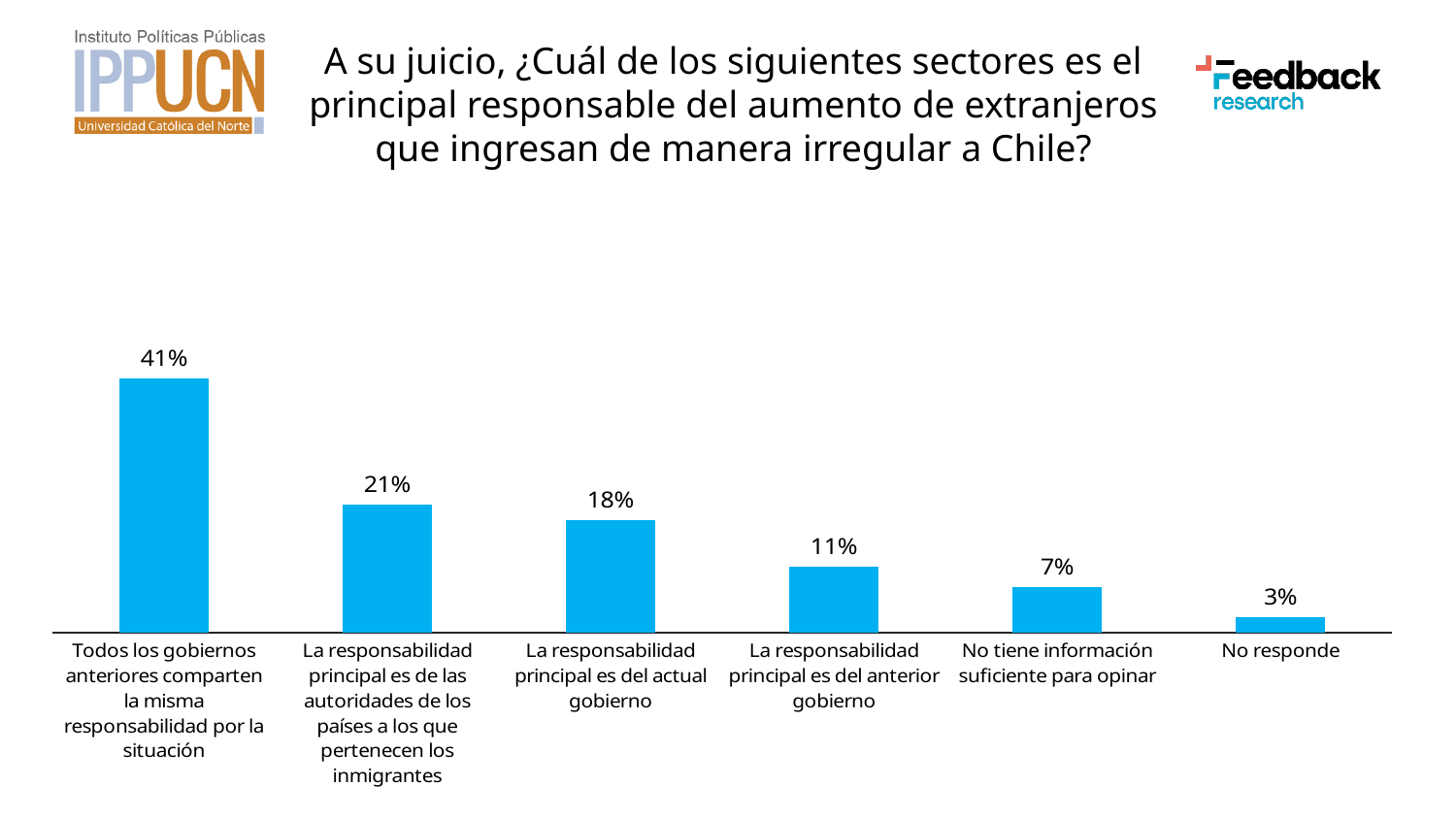
What is the difference between the highest and lowest values in the chart? 38% What is the value for "No responde"? 3% Which is larger: the value for "La responsabilidad principal es del actual gobierno" or the value for "La responsabilidad principal es del anterior gobierno"? La responsabilidad principal es del actual gobierno What is the difference between the value for "La responsabilidad principal es de las autoridades de los países a los que pertenecen los inmigrantes" and the value for "La responsabilidad principal es del anterior gobierno"? 10% What is the value for "La responsabilidad principal es del actual gobierno"? 18% Do the values rise or fall from left to right along the x axis? Fall What is the value for "Todos los gobiernos anteriores comparten la misma responsabilidad por la situación"? 41% What is the value for "No tiene información suficiente para opinar"? 7% Which category has the highest value? Todos los gobiernos anteriores comparten la misma responsabilidad por la situación What kind of chart is shown on the slide? Bar chart How many categories are shown in the chart? 6 Which category has the lowest value? No responde